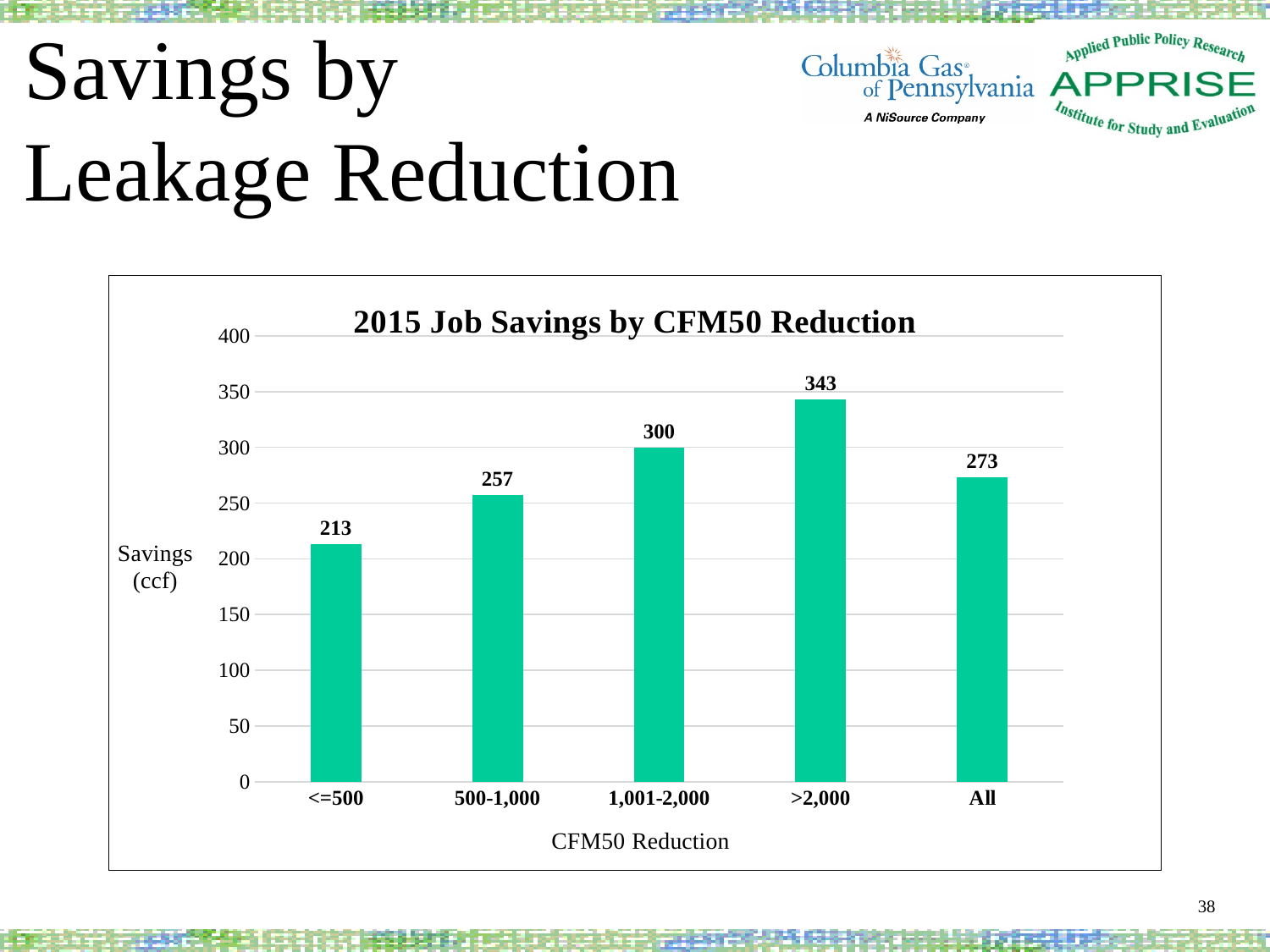
What is the savings value for the <=500 CFM50 reduction category? 213 What is the difference in savings between the >2,000 category and the <=500 category? 130 What is the title of the chart? 2015 Job Savings by CFM50 Reduction Which has higher savings, the 1,001-2,000 category or the All category? 1,001-2,000 What is the savings value for the 500-1,000 CFM50 reduction category? 257 Do the savings values rise or fall across the first four CFM50 reduction categories, from <=500 to >2,000? Rise How many categories are shown on the x axis of the chart? 5 What is the savings value for the 1,001-2,000 CFM50 reduction category? 300 Which CFM50 reduction category has the lowest savings? <=500 What kind of chart is shown on the slide? Bar chart What is the savings value for the All category? 273 Which CFM50 reduction category has the highest savings? >2,000